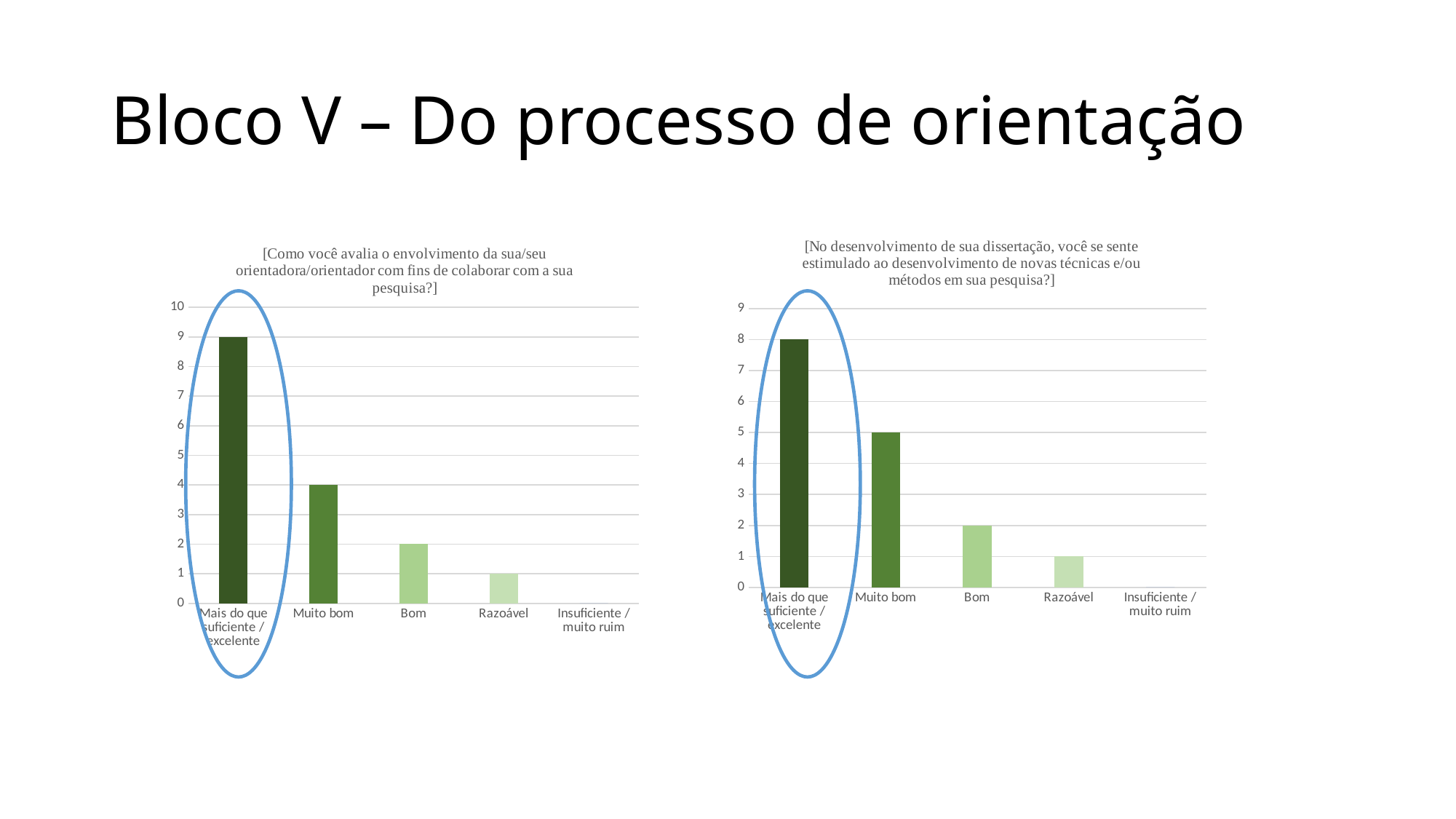
On the left chart, how many categories are shown on the x axis? 5 On the left chart, what is the difference between 'Mais do que suficiente / excelente' and 'Muito bom'? 5 What kind of chart is the right chart? bar chart On the right chart, is the value for 'Muito bom' larger or smaller than the value for 'Razoável'? larger On the right chart, what is the difference between 'Mais do que suficiente / excelente' and 'Muito bom'? 3 On the left chart, which category has the highest value? Mais do que suficiente / excelente On the right chart, which category has the lowest value? Insuficiente / muito ruim On the left chart, what is the value for 'Muito bom'? 4 On the left chart, what is the value for 'Razoável'? 1 On the right chart, do the values rise or fall from left to right along the x axis? fall On the right chart, what is the value for 'Bom'? 2 On the right chart, what is the value for 'Mais do que suficiente / excelente'? 8